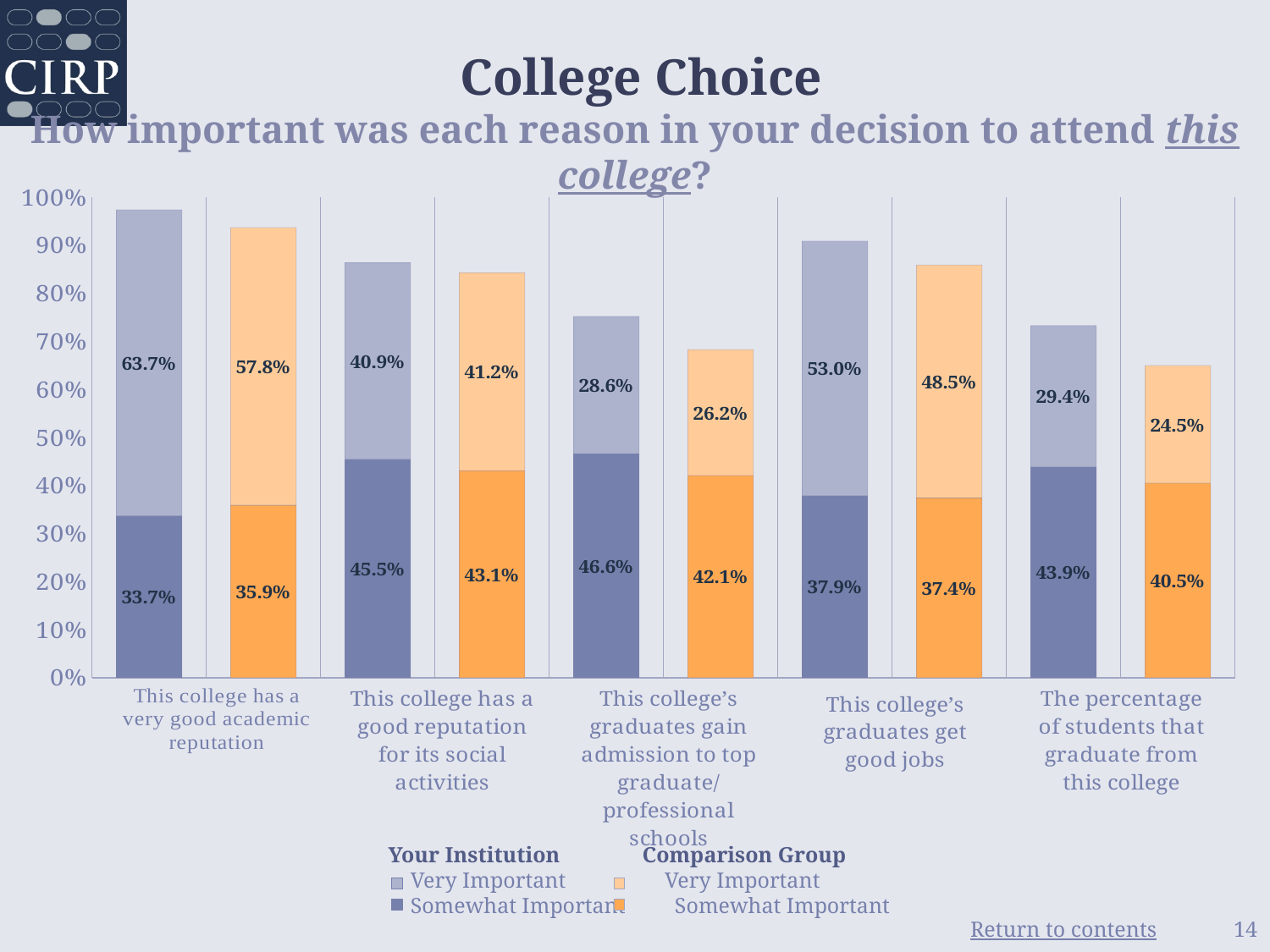
Which reason has the lowest Very Important percentage for the Comparison Group? The percentage of students that graduate from this college What is the Comparison Group's Somewhat Important value for 'This college's graduates get good jobs'? 37.4% How many series does the legend list? 4 What kind of chart is shown on the slide? Stacked bar chart What is the total height of the Comparison Group stacked bar for 'The percentage of students that graduate from this college'? 65.0% How many reasons (categories) are shown along the x axis? 5 Which reason has the highest Very Important percentage for Your Institution? This college has a very good academic reputation What is the total height of the Your Institution stacked bar for 'This college has a very good academic reputation'? 97.4% What is the difference between Your Institution's and the Comparison Group's Very Important values for 'This college's graduates get good jobs'? 4.5% What percentage of Your Institution students rated 'This college has a very good academic reputation' as Very Important? 63.7% Which colour represents the Comparison Group's Somewhat Important series in the legend? Orange For 'This college has a good reputation for its social activities', which is larger: Your Institution's Somewhat Important value or the Comparison Group's Somewhat Important value? Your Institution (45.5%)